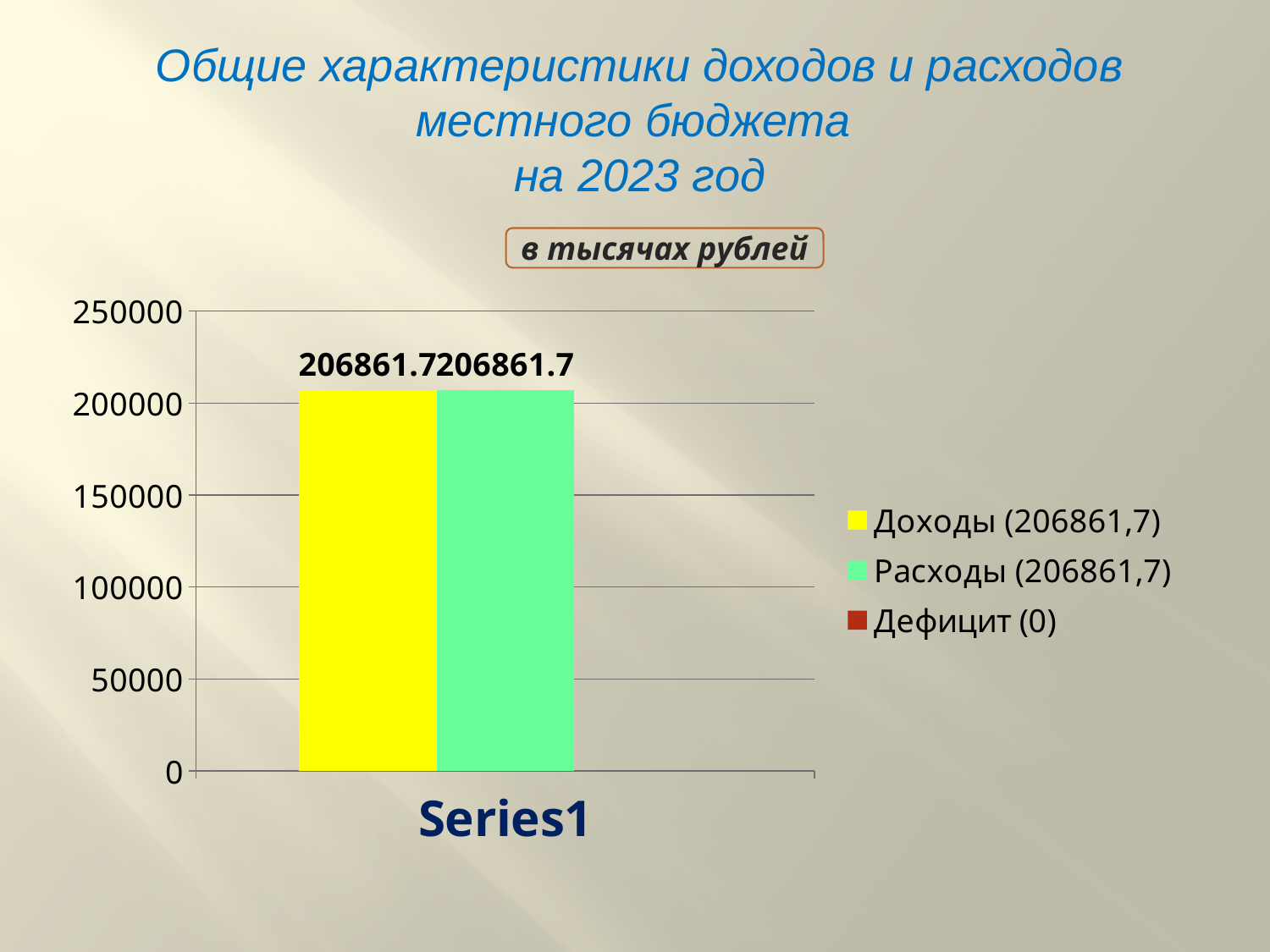
What is the category label shown on the x axis? Series1 Is the value for Расходы greater or less than 250000? less What is the value of the Доходы bar? 206861.7 What is the value of the Расходы bar? 206861.7 Which series has the lowest value according to the legend? Дефицит What type of chart is shown on the slide? bar chart What is the difference between the Доходы and Расходы values? 0 Is the value for Доходы greater or less than 200000? greater How many series does the legend list? 3 What unit is stated above the chart? в тысячах рублей What is the highest value shown on the y axis? 250000 What value does the legend give for Дефицит? 0